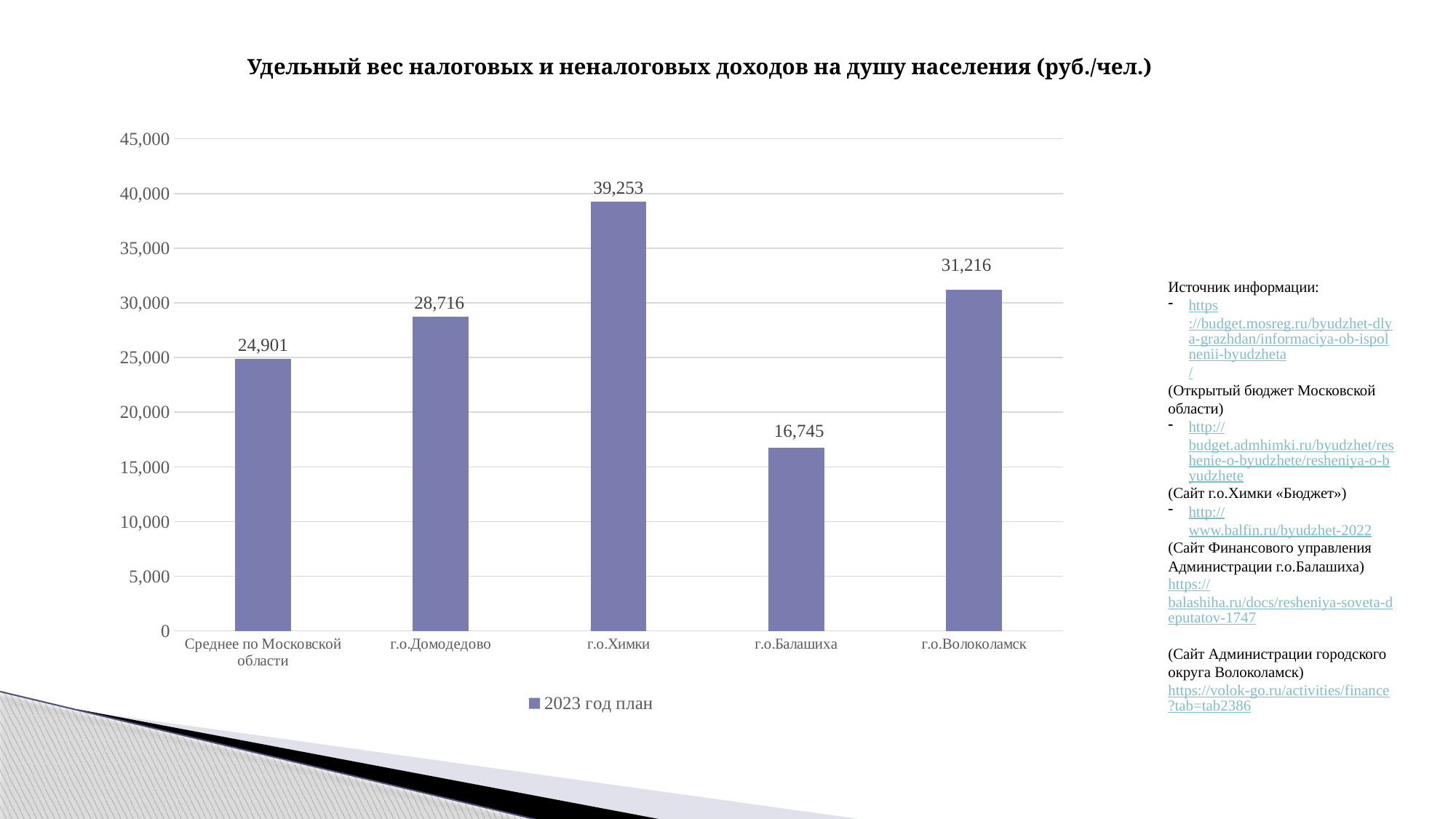
Which category has the lowest value? г.о.Балашиха What is the difference between the values for г.о.Волоколамск and г.о.Домодедово? 2,500 What is the value for г.о.Химки? 39,253 What is the value for г.о.Балашиха? 16,745 What is the value for Среднее по Московской области? 24,901 How many categories are shown on the x axis? 5 Which is larger, the value for г.о.Домодедово or the value for г.о.Волоколамск? г.о.Волоколамск What series does the legend list? 2023 год план What kind of chart is shown on the slide? bar chart Is the value for г.о.Домодедово greater or less than 25,000? greater Which category has the highest value? г.о.Химки What is the difference between the values for г.о.Химки and г.о.Балашиха? 22,508